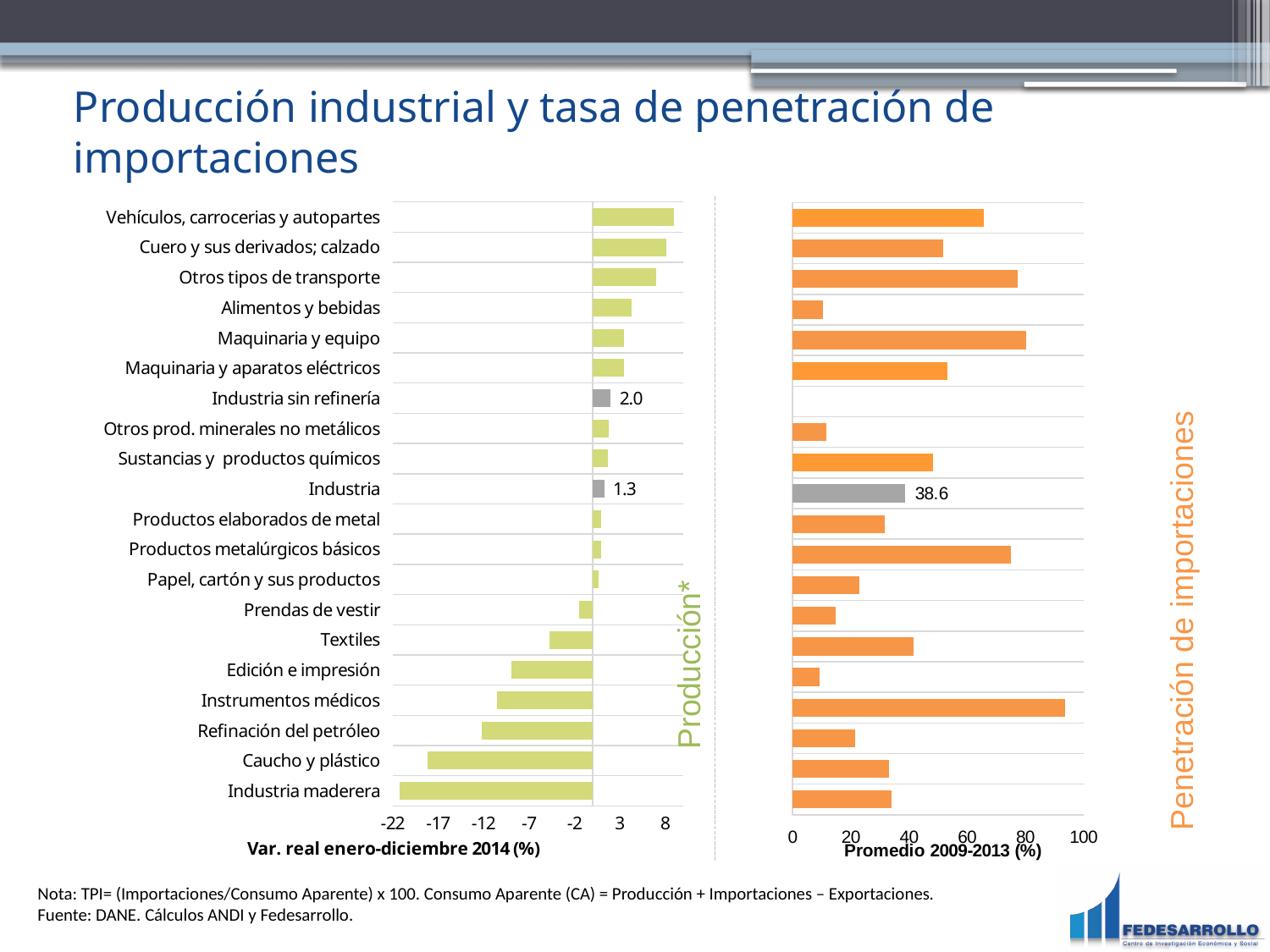
In the right chart (Penetración de importaciones), is the value for Alimentos y bebidas greater or less than 20? less In the right chart (Penetración de importaciones), what is the value for Industria? 38.6 In the left chart (Producción*), what is the value for Industria? 1.3 What kind of chart is the right chart (Penetración de importaciones)? bar chart In the right chart (Penetración de importaciones), which is larger: the value for Vehículos, carrocerias y autopartes or for Cuero y sus derivados; calzado? Vehículos, carrocerias y autopartes In the left chart (Producción*), is the value for Caucho y plástico greater or less than -12? less In the left chart (Producción*), which category has the lowest value? Industria maderera In the left chart (Producción*), what is the difference between the values for Industria sin refinería and Industria? 0.7 In the left chart (Producción*), what is the value for Industria sin refinería? 2.0 In the left chart (Producción*), which category has the highest value? Vehículos, carrocerias y autopartes How many categories are listed on the left chart (Producción*)? 20 In the right chart (Penetración de importaciones), which category has the highest value? Instrumentos médicos